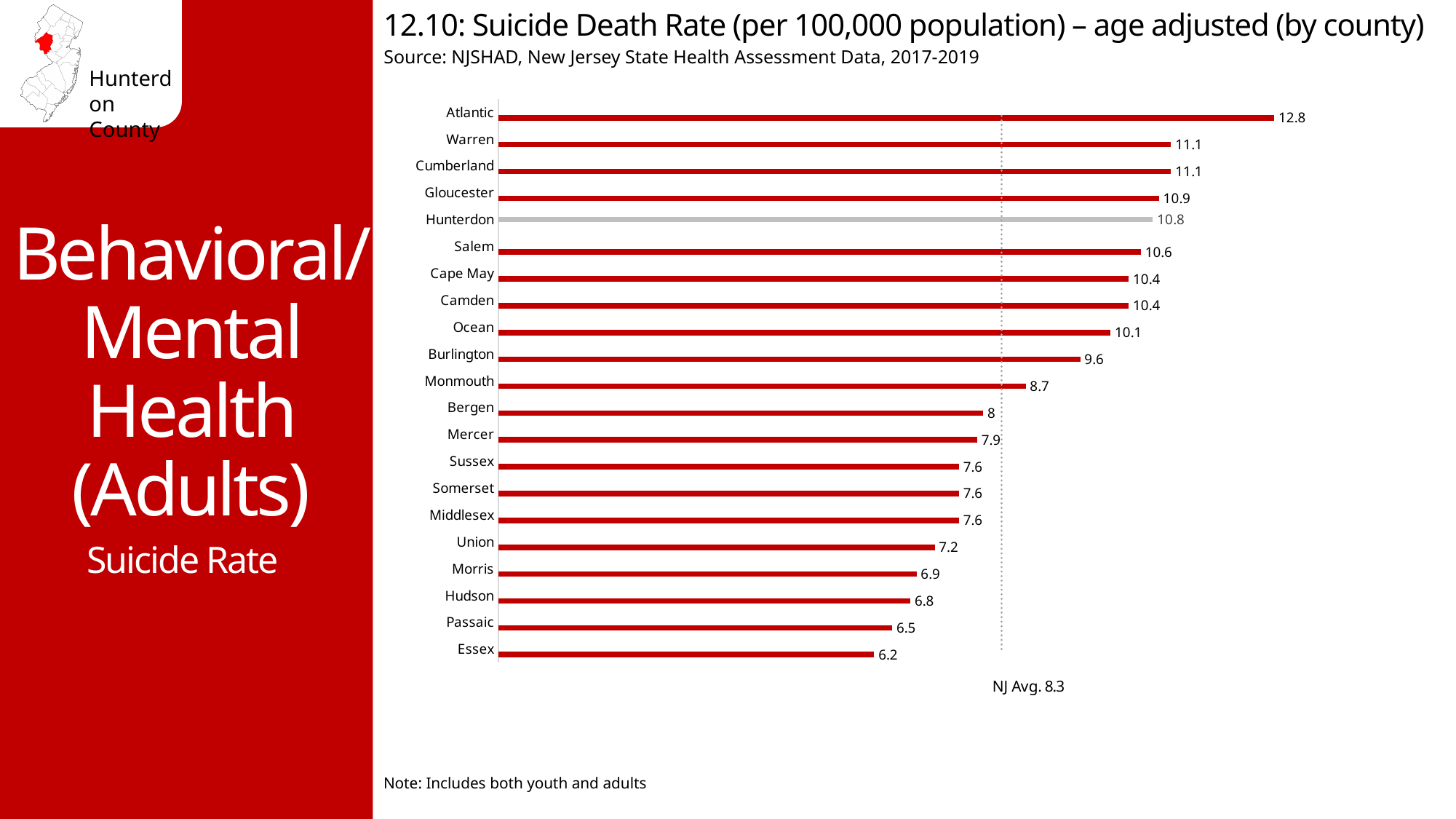
Which county has a higher suicide death rate, Gloucester or Hunterdon? Gloucester What type of chart is shown on the slide? Bar chart Which county's bar is shown in gray instead of red? Hunterdon What is the suicide death rate for Hunterdon County? 10.8 What is the difference between the suicide death rates of Atlantic and Essex counties? 6.6 Which county has the lowest suicide death rate? Essex How much higher is Hunterdon County's suicide death rate than the NJ average? 2.5 What is the NJ average suicide death rate shown on the chart? 8.3 Which county has the highest suicide death rate? Atlantic How many counties are shown in the chart? 21 What is the suicide death rate for Atlantic County? 12.8 What is the suicide death rate for Essex County? 6.2